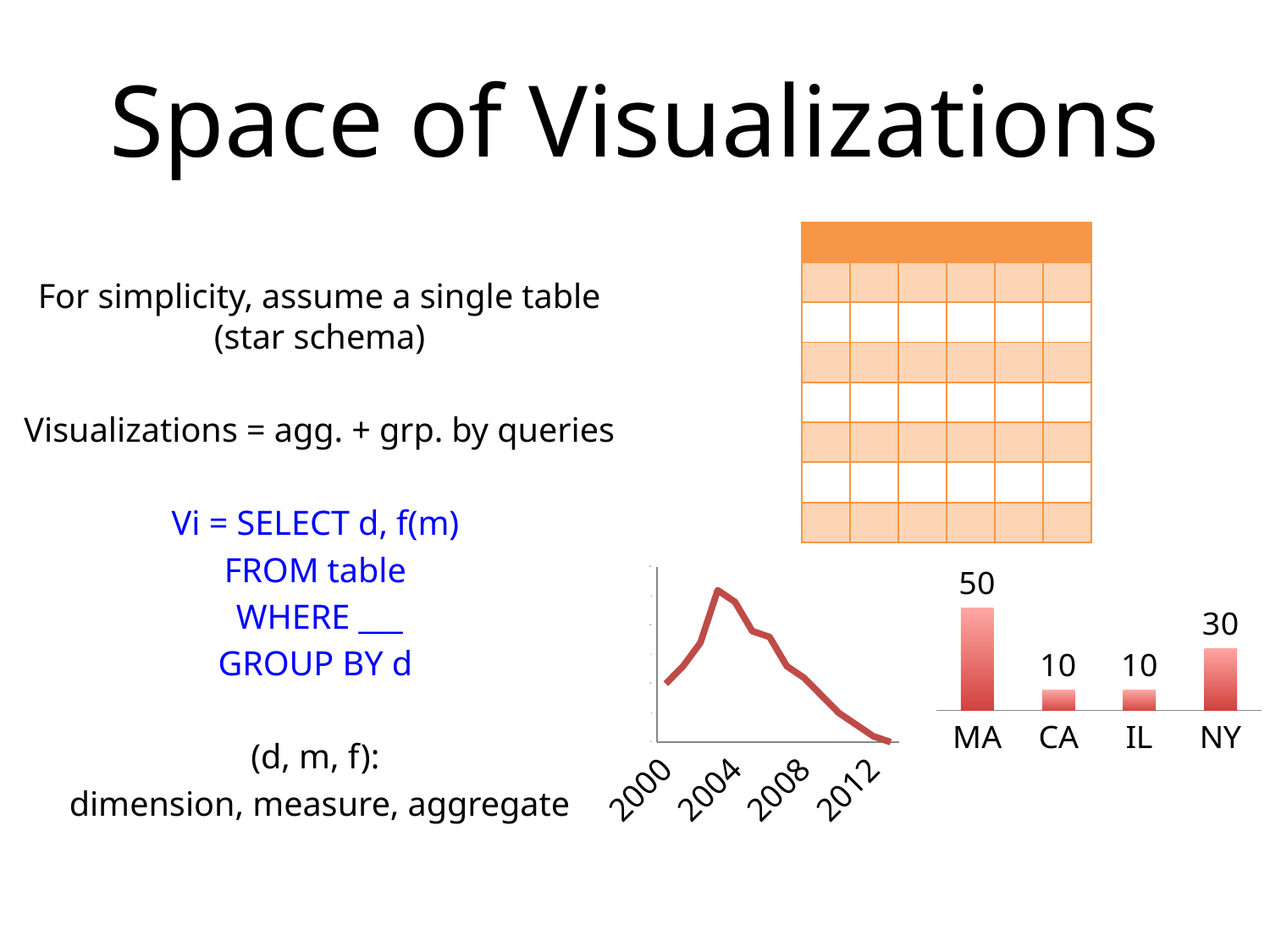
How many categories are shown in the bar chart on the right? 4 In the bar chart on the right, which category has the highest value? MA In the bar chart on the right, what is the value for CA? 10 In the bar chart on the right, what is the difference between the values for MA and CA? 40 In the line chart in the bottom middle, does the line rise or fall between 2004 and 2012? fall In the bar chart on the right, which is larger, the value for NY or the value for IL? NY In the bar chart on the right, what is the value for NY? 30 In the bar chart on the right, what is the value for MA? 50 What kind of chart is the chart in the bottom middle with years 2000 to 2012 on the x axis? line chart What kind of chart is the chart on the right with MA, CA, IL and NY? bar chart What is the sum of all the bar values in the bar chart on the right? 100 In the bar chart on the right, what is the difference between the values for MA and NY? 20